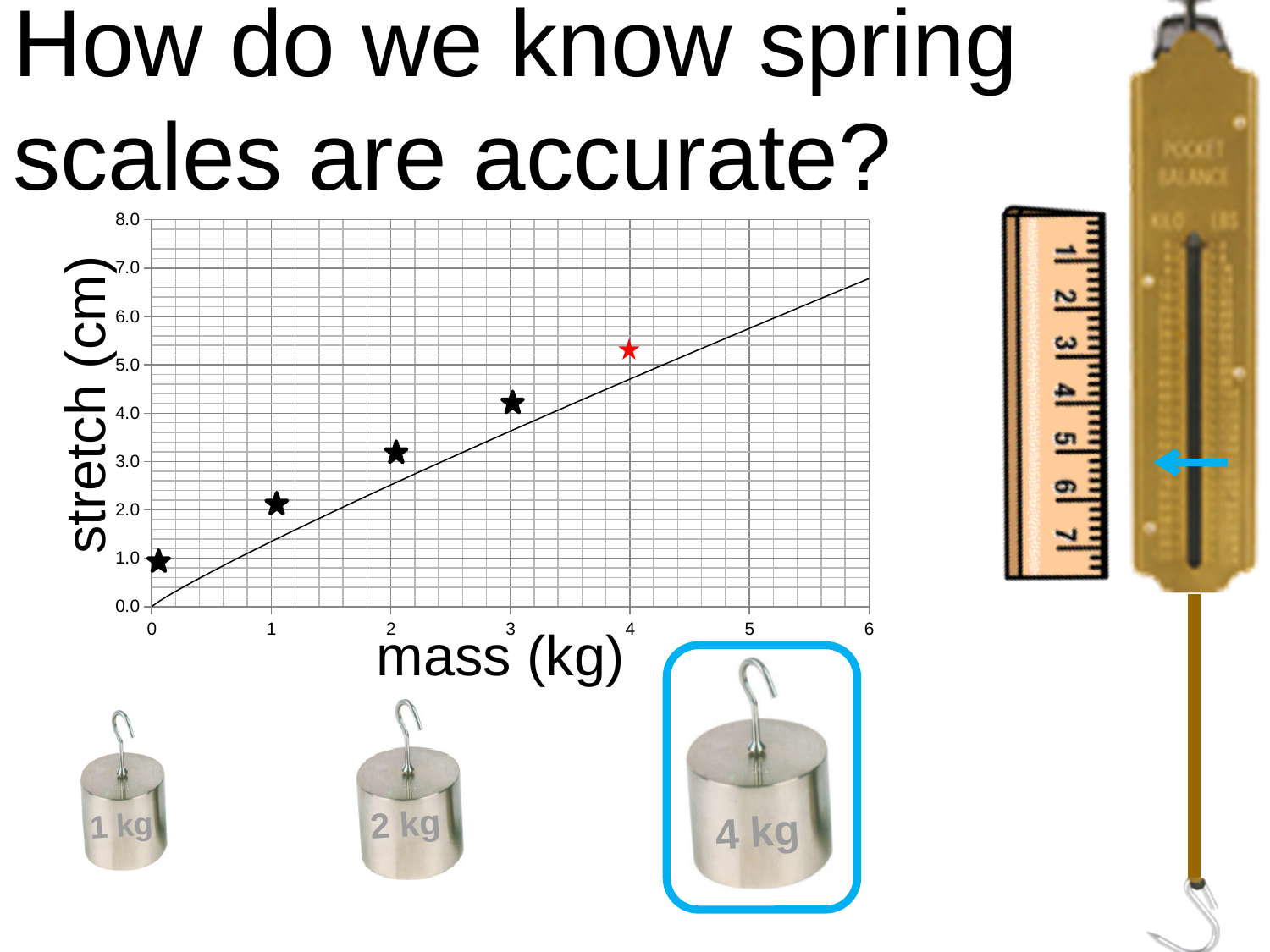
What kind of chart is shown on the slide? scatter chart Is the stretch value plotted at 1 kg greater or less than 3.0 cm? less Which mass has the highest plotted stretch value? 4 kg Which has a larger plotted stretch value, 2 kg or 3 kg? 3 kg Is the stretch value plotted at 4 kg greater or less than 5.0 cm? greater Do the plotted stretch values rise or fall as mass increases along the x axis? rise Is the stretch value plotted at 2 kg greater or less than 4.0 cm? less What is the label of the vertical axis of the chart? stretch (cm) How many star data points are plotted on the chart? 5 Which mass has the lowest plotted stretch value? 0 kg What colour is the star plotted at 4 kg? red